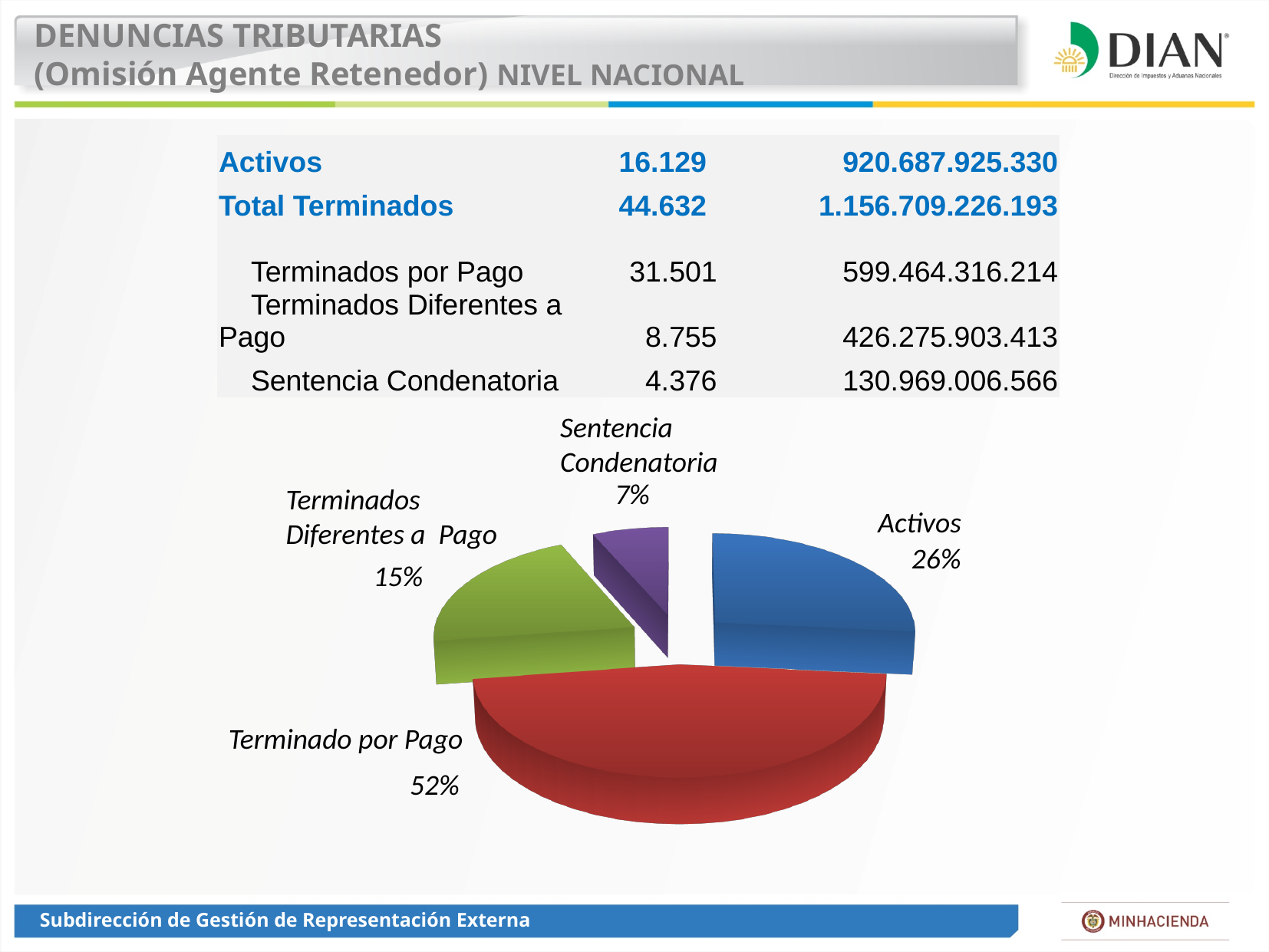
Which is larger in the pie chart, Activos or Terminados Diferentes a Pago? Activos What share of the pie does the Terminado por Pago slice represent? 52% What colour is the Terminado por Pago slice in the pie chart? Red What is the difference in percentage points between the Terminados Diferentes a Pago slice and the Sentencia Condenatoria slice? 8 Which slice of the pie chart is the smallest? Sentencia Condenatoria What share of the pie does the Terminados Diferentes a Pago slice represent? 15% Which slice of the pie chart is the largest? Terminado por Pago How many slices does the pie chart have? 4 What share of the pie does the Sentencia Condenatoria slice represent? 7% What is the difference in percentage points between the Terminado por Pago slice and the Activos slice? 26 What kind of chart is shown on the slide? Pie chart